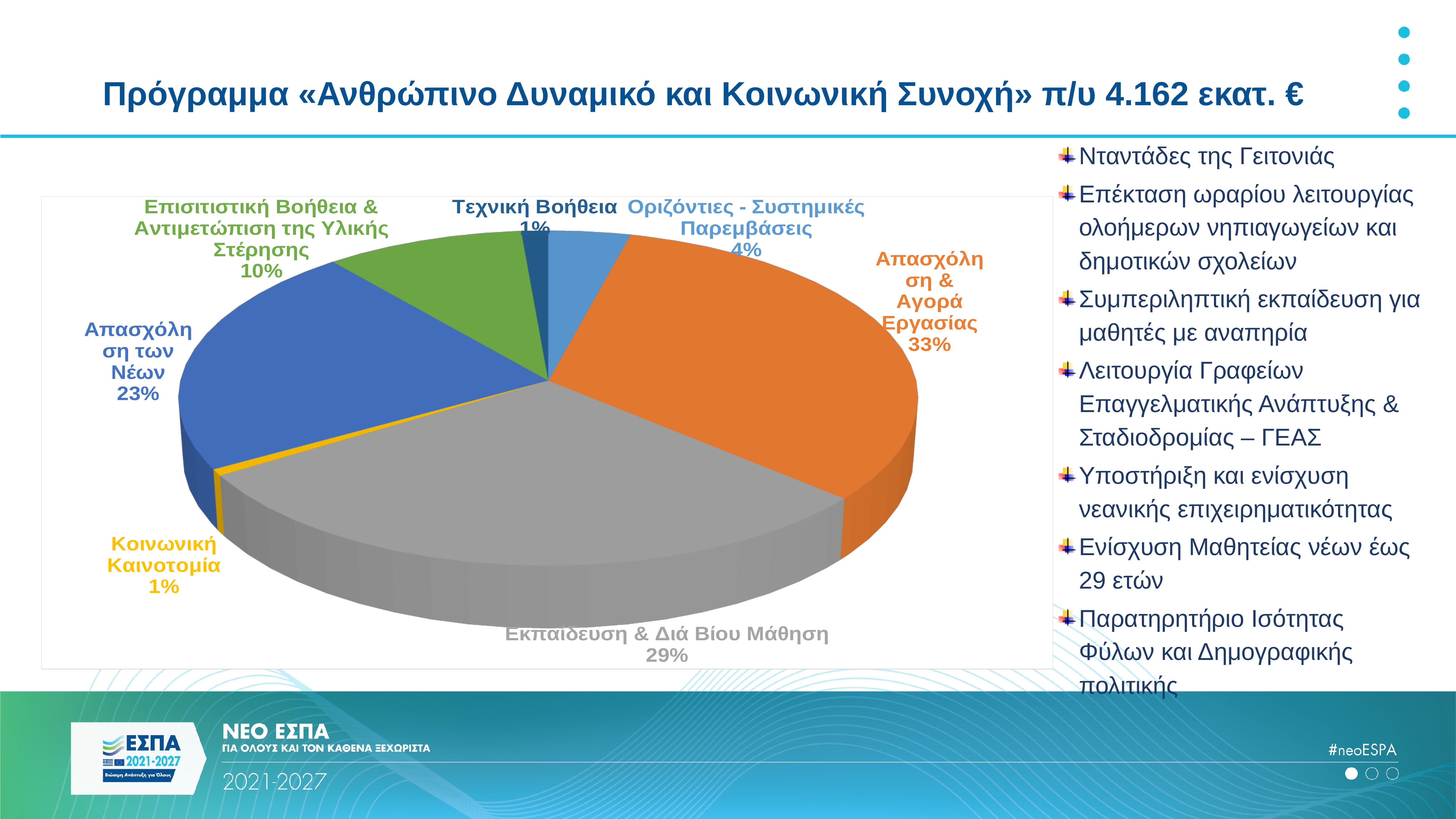
What colour is the slice for «Εκπαίδευση & Διά Βίου Μάθηση»? grey What percentage is shown for «Απασχόληση των Νέων»? 23% What share of the pie does «Απασχόληση & Αγορά Εργασίας» have? 33% What percentage is shown for «Εκπαίδευση & Διά Βίου Μάθηση»? 29% What is the difference in percentage points between «Απασχόληση & Αγορά Εργασίας» and «Εκπαίδευση & Διά Βίου Μάθηση»? 4 What type of chart is shown on the slide? pie chart What percentage is shown for «Οριζόντιες - Συστημικές Παρεμβάσεις»? 4% What percentage is shown for «Επισιτιστική Βοήθεια & Αντιμετώπιση της Υλικής Στέρησης»? 10% How many slices does the pie chart have? 7 Which category has the largest slice of the pie? Απασχόληση & Αγορά Εργασίας Which is larger, the slice for «Απασχόληση των Νέων» or the slice for «Επισιτιστική Βοήθεια & Αντιμετώπιση της Υλικής Στέρησης»? Απασχόληση των Νέων What percentage is shown for «Κοινωνική Καινοτομία»? 1%